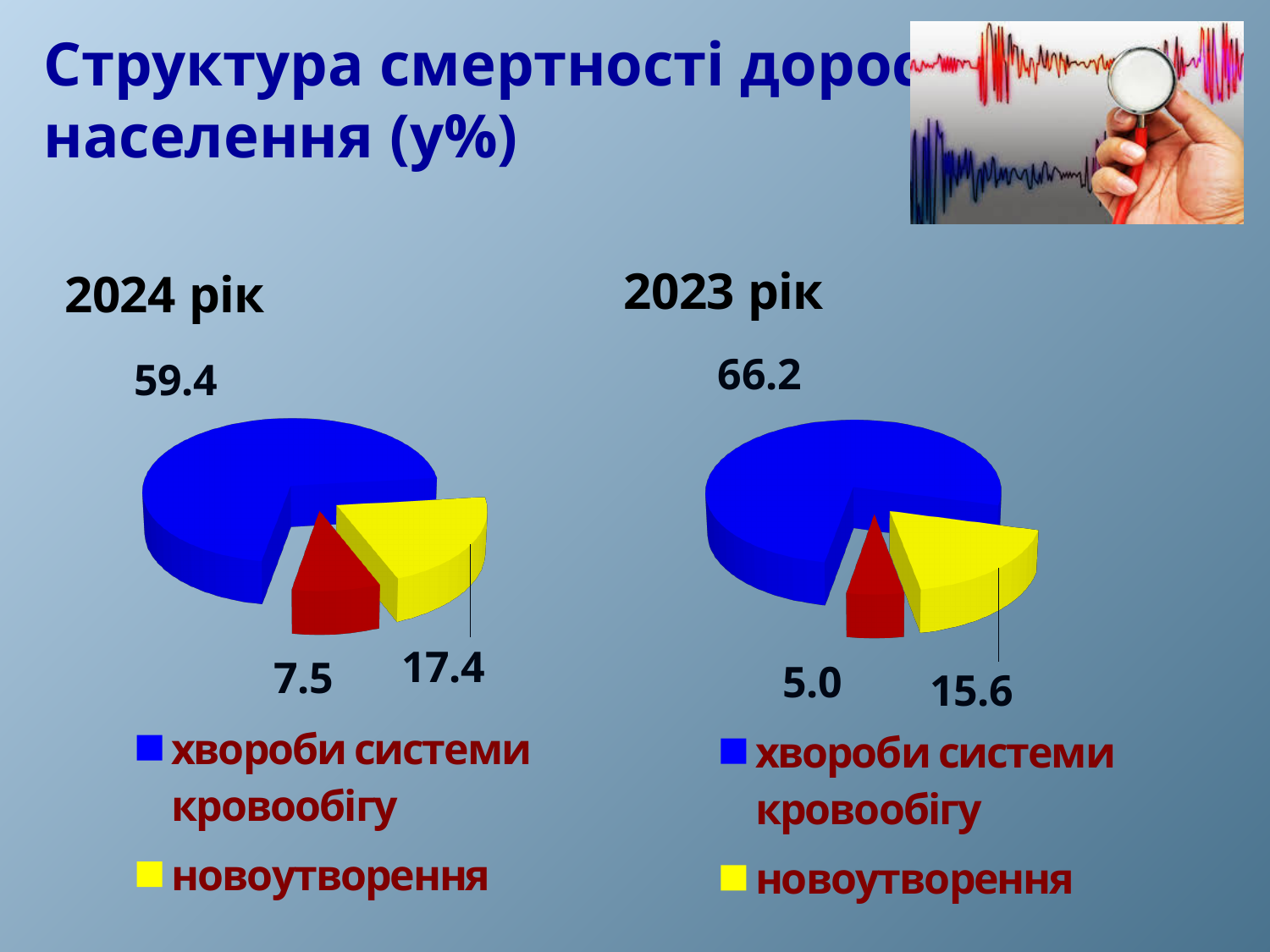
In the 2024 рік chart, what is the value for новоутворення? 17.4 In the 2024 рік chart, which category has the largest slice? хвороби системи кровообігу What kind of chart is used for the 2024 рік data? pie chart In the 2024 рік chart, what is the value for хвороби системи кровообігу? 59.4 In the 2023 рік chart, what is the value for новоутворення? 15.6 In the 2023 рік chart, what is the difference between хвороби системи кровообігу and новоутворення? 50.6 In the 2023 рік chart, what value is shown for the red slice? 5.0 How many entries does the legend of the 2024 рік chart list? 2 Is the value for новоутворення larger in the 2024 рік chart or the 2023 рік chart? 2024 рік In the 2024 рік chart, what is the smallest value shown? 7.5 How many slices does the 2023 рік pie chart have? 3 In the 2023 рік chart, what is the value for хвороби системи кровообігу? 66.2